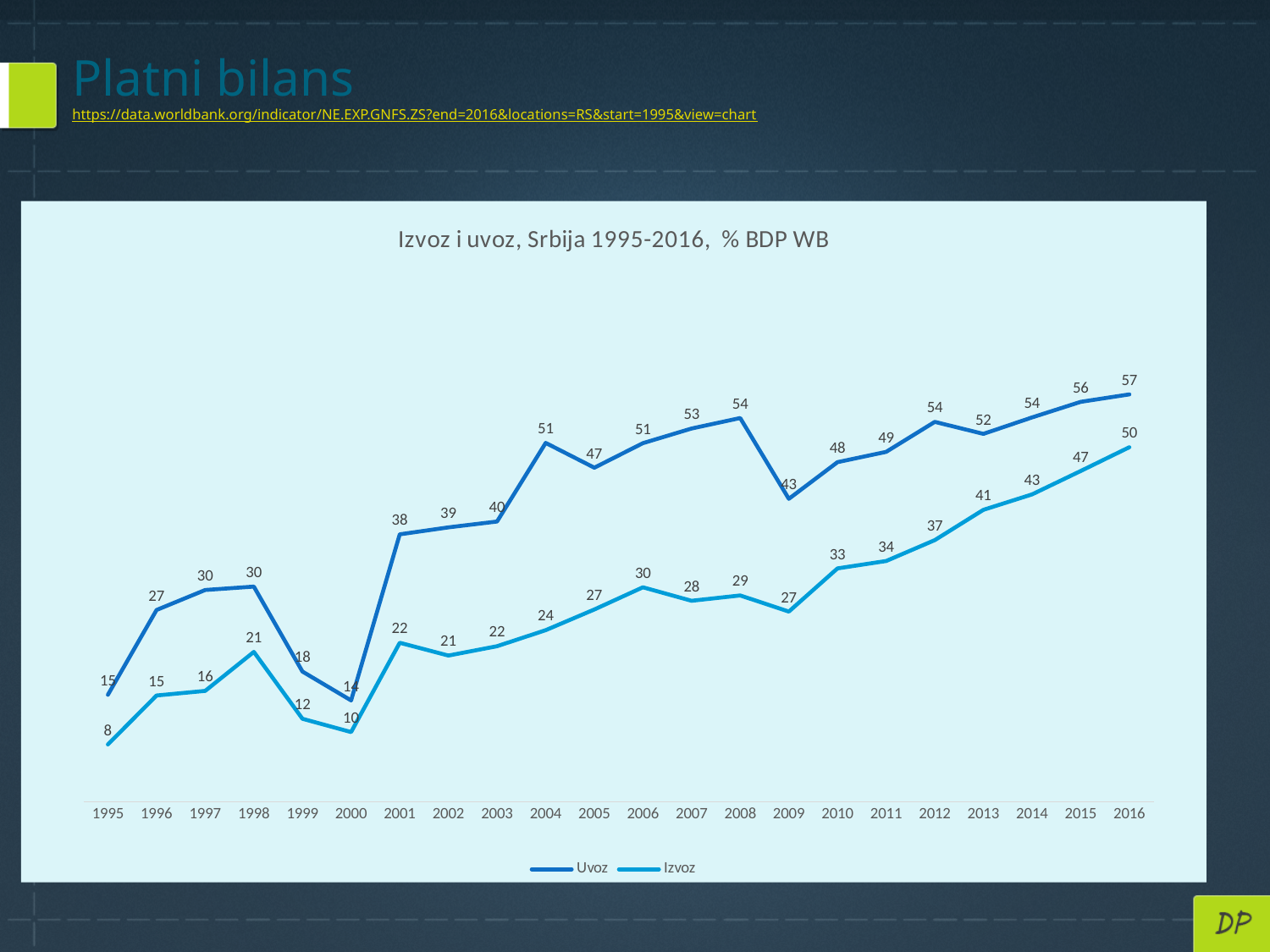
What is the difference between Uvoz and Izvoz in 2016? 7 How many series does the legend list? 2 How many years are plotted on the x axis? 22 What is the value of Izvoz in 2009? 27 What is the title of the chart? Izvoz i uvoz, Srbija 1995-2016, % BDP WB What is the value of Uvoz in 2000? 14 Does Izvoz rise or fall from 2010 to 2016? Rise In which year is Uvoz at its highest? 2016 What is the value of Uvoz in 2004? 51 Which is larger in 2008, Uvoz or Izvoz? Uvoz What type of chart is shown on the slide? Line chart In which year is Izvoz at its lowest? 1995